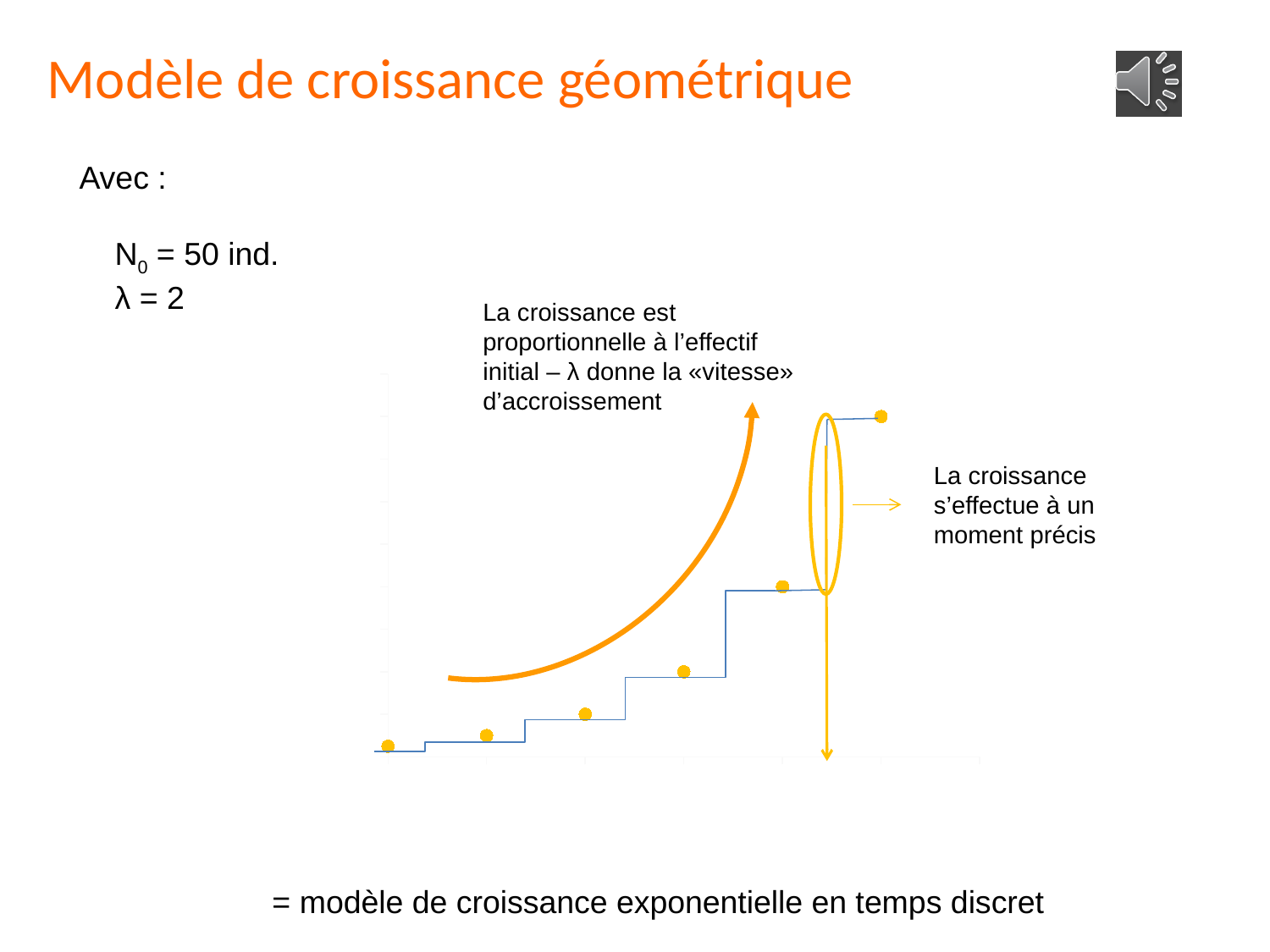
Is the rightmost point higher or lower than the second point from the right? higher How many data points (markers) are plotted on the chart? 6 What kind of chart is shown on the slide? line chart (step line with markers) Do the plotted values rise or fall from left to right along the x axis? rise Does the chart show a linear or an accelerating (exponential-like) increase in values? accelerating What colour are the data point markers on the chart? yellow Which point is the lowest on the chart, the leftmost or the rightmost? the leftmost Which point is the highest on the chart, the leftmost or the rightmost? the rightmost